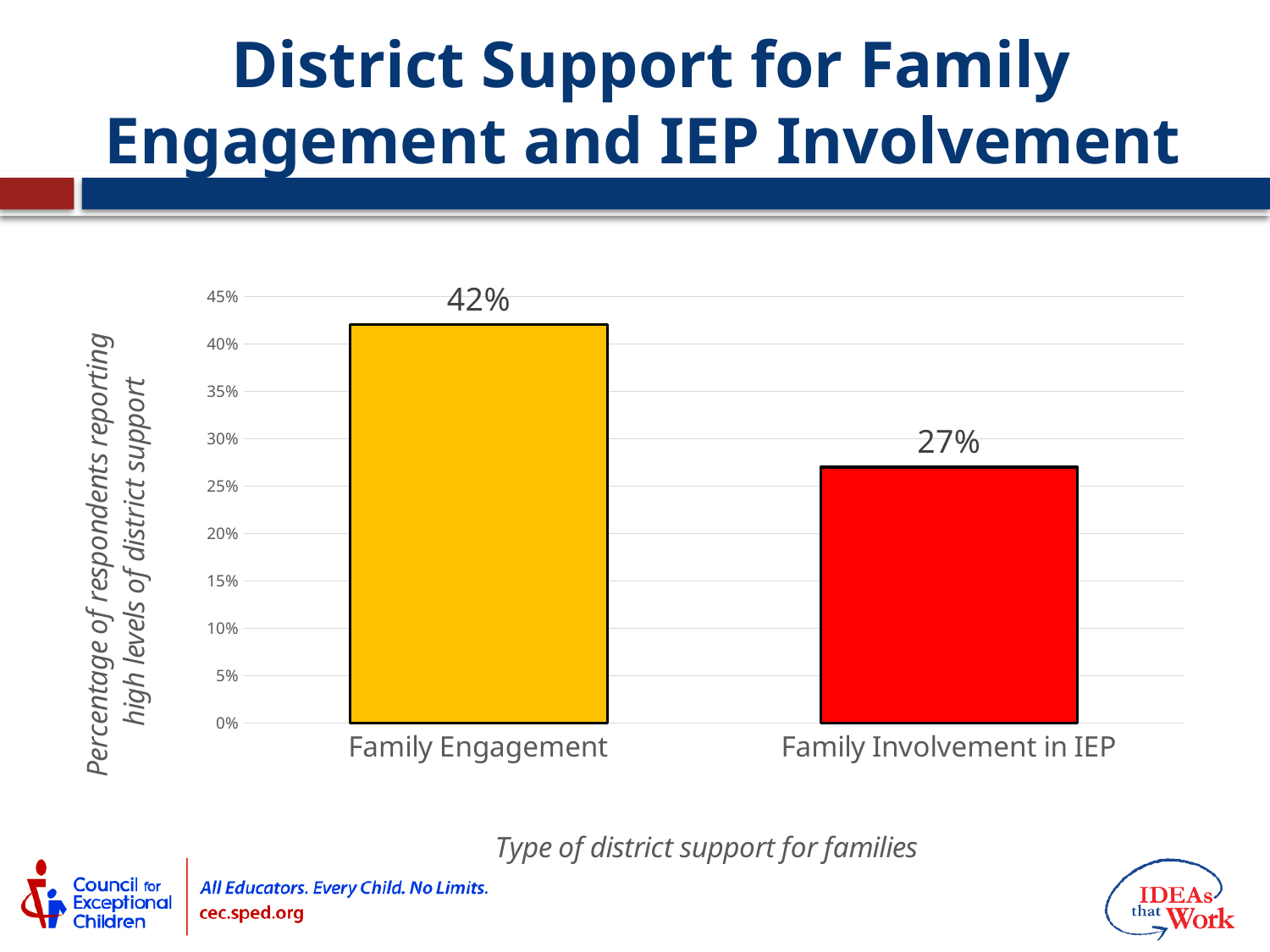
Is the value for Family Involvement in IEP greater or less than 30%? less What percentage of respondents reported high levels of district support for Family Involvement in IEP? 27% What colour is the bar for Family Involvement in IEP? red Which type of district support has the lower percentage of respondents reporting high levels of support? Family Involvement in IEP What kind of chart is shown on the slide? bar chart What is the difference in percentage points between Family Engagement and Family Involvement in IEP? 15 Is the value for Family Engagement greater or less than 40%? greater How many categories are shown on the x axis of the chart? 2 What is the x-axis title of the chart? Type of district support for families What percentage of respondents reported high levels of district support for Family Engagement? 42% Which type of district support has the higher percentage of respondents reporting high levels of support? Family Engagement Is the value for Family Engagement larger or smaller than the value for Family Involvement in IEP? larger